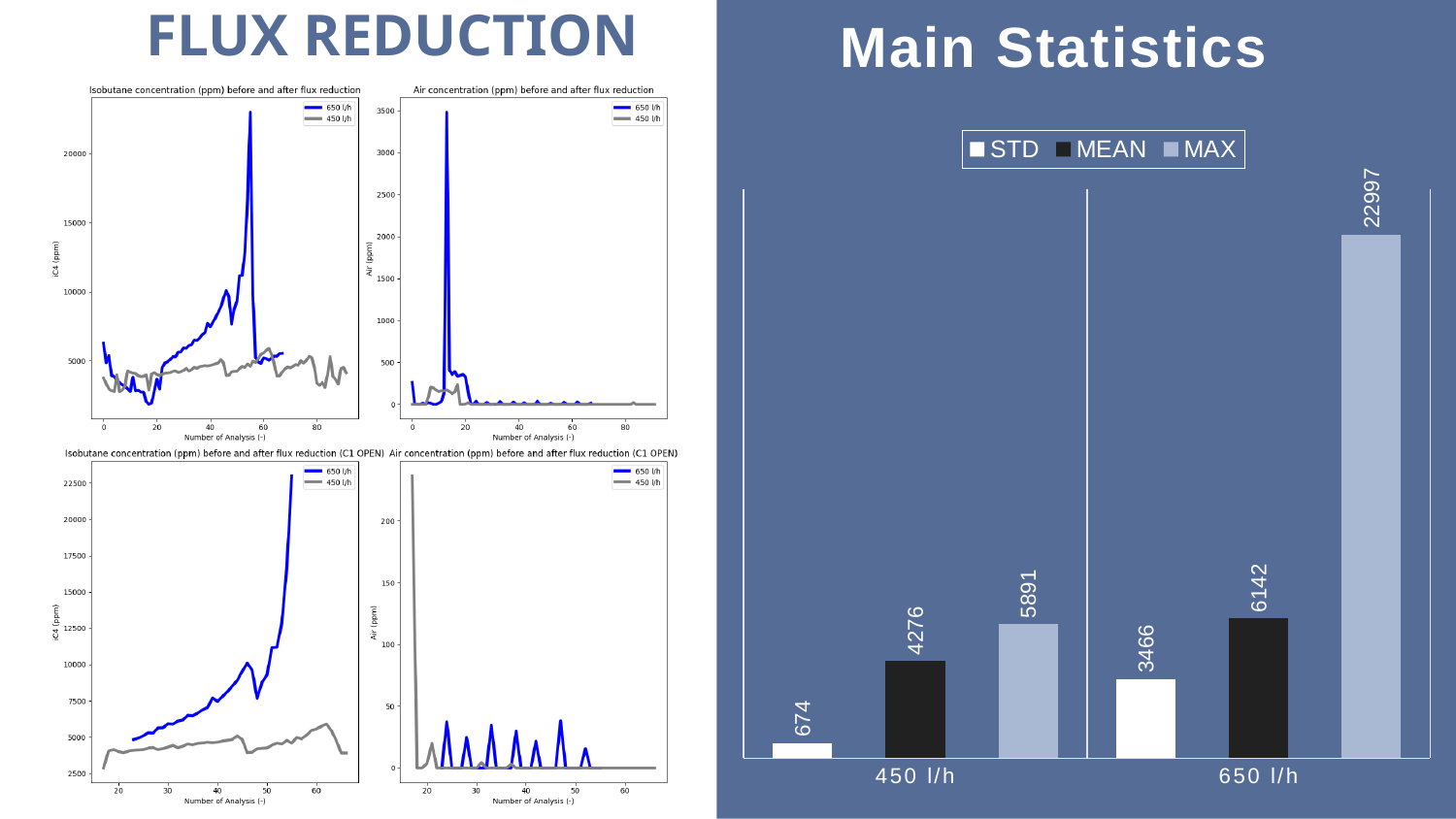
In the Main Statistics chart, what is the MEAN value for 650 l/h? 6142 In the Main Statistics chart, what is the MAX value for 450 l/h? 5891 In the Main Statistics chart, what is the STD value for 450 l/h? 674 In the Main Statistics chart, what is the difference between the MEAN values for 650 l/h and 450 l/h? 1866 In the Main Statistics chart, which bar has the highest value? MAX for 650 l/h In the Main Statistics chart, what is the MAX value for 650 l/h? 22997 In the Main Statistics chart, which is larger: the MAX for 450 l/h or the MEAN for 650 l/h? MEAN for 650 l/h How many series does the legend of the Main Statistics chart list? 3 What kind of chart is the Main Statistics chart? Bar chart In the Main Statistics chart, which bar has the lowest value? STD for 450 l/h In the Main Statistics chart, what is the difference between the STD values for 650 l/h and 450 l/h? 2792 In the Main Statistics chart, which colour represents the MEAN series? Black